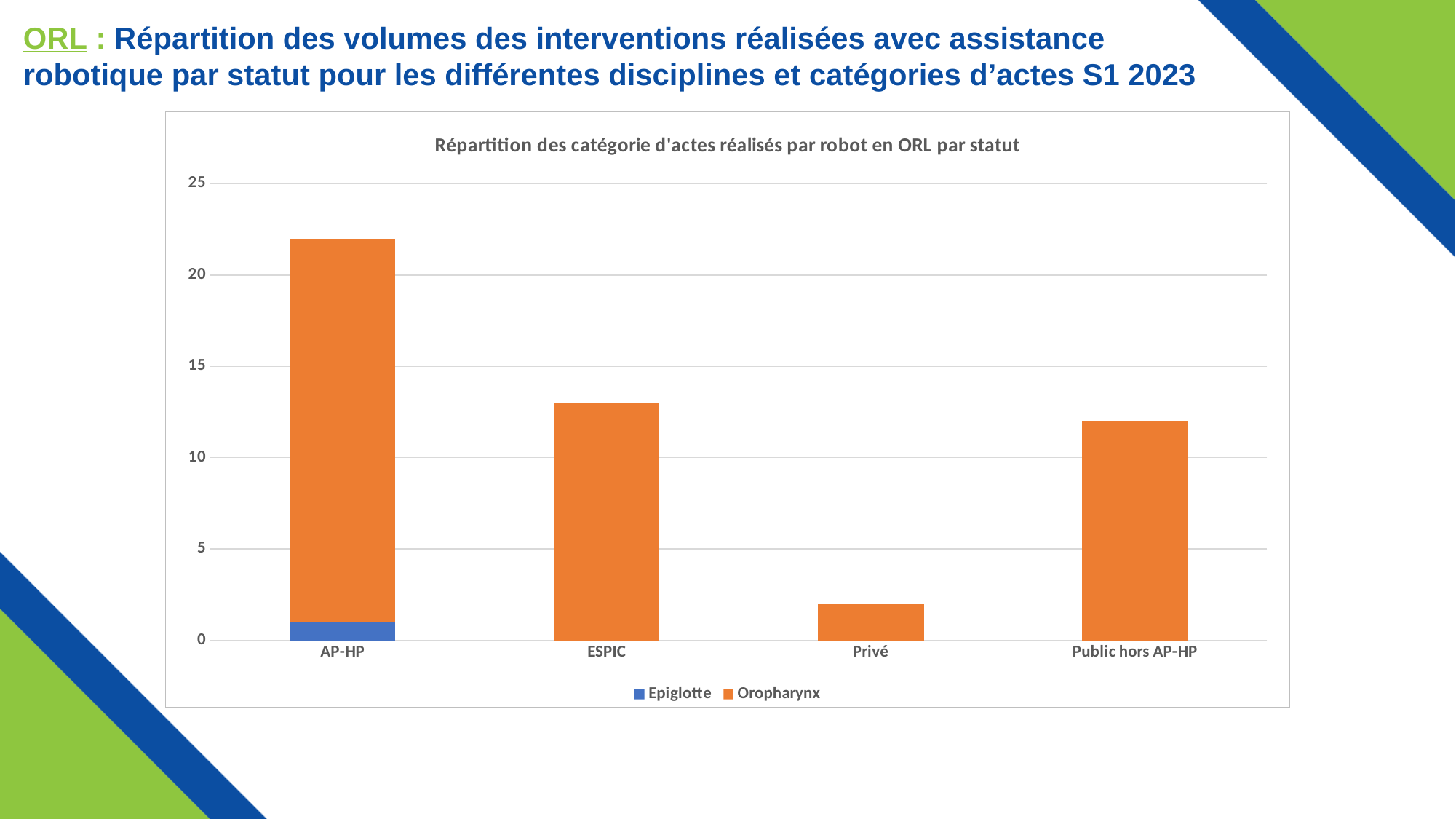
What kind of chart is shown on the slide? bar chart How many series does the chart legend list? 2 Which series is shown in orange in the chart legend? Oropharynx Which statut category has the tallest bar in the chart? AP-HP Is the value for Public hors AP-HP greater or less than 10? greater Is the total bar height for AP-HP greater or less than 20? greater Which bar is taller, AP-HP or ESPIC? AP-HP Which bar is taller, Privé or Public hors AP-HP? Public hors AP-HP Is the value for Privé greater or less than 5? less Which statut category has the shortest bar in the chart? Privé How many statut categories are shown on the x axis of the chart? 4